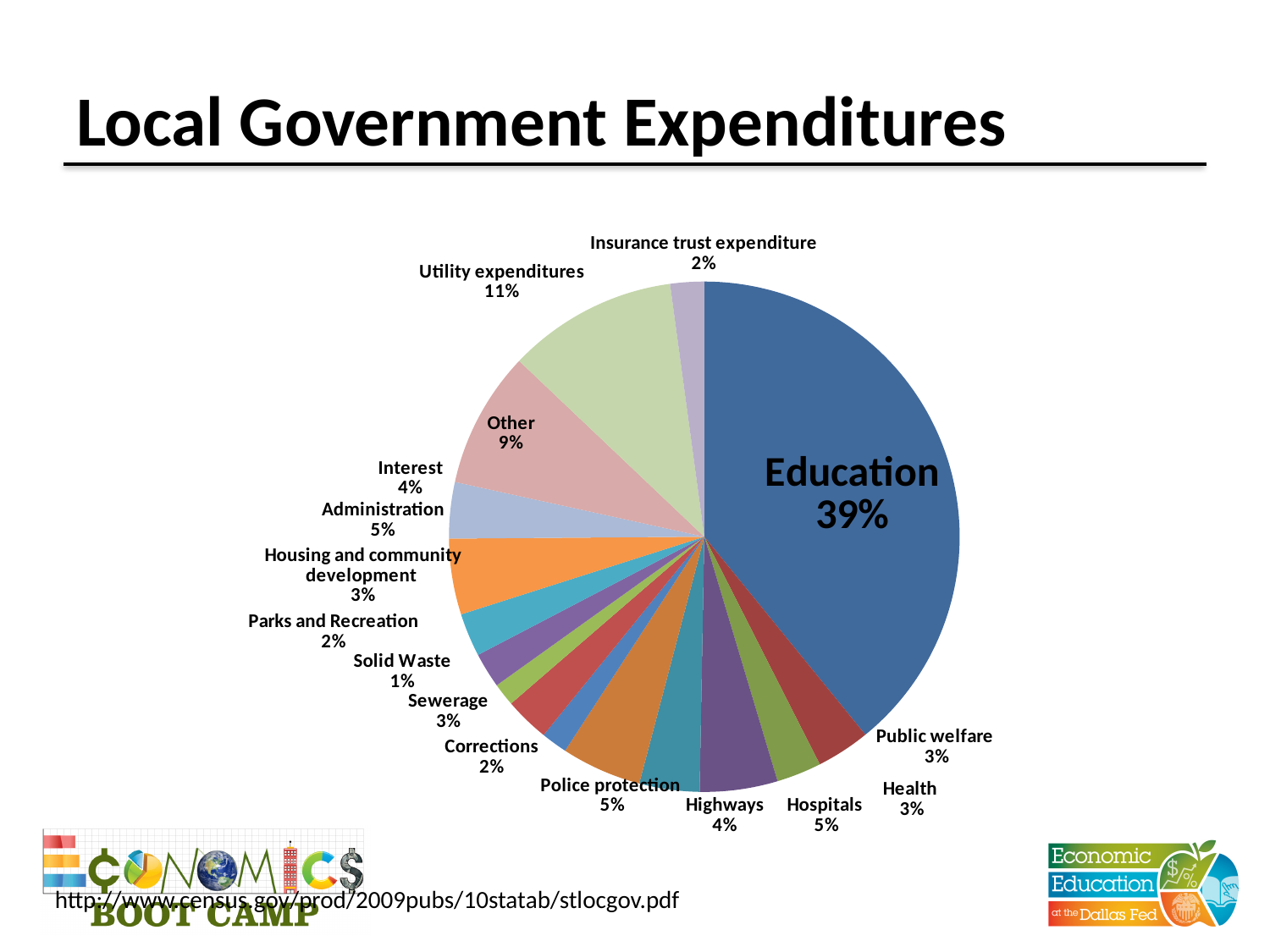
Which category has the smallest share of local government expenditures? Solid Waste What percentage is shown for Police protection? 5% What percentage is shown for Solid Waste? 1% Which category has the largest share of local government expenditures? Education What type of chart is shown on the slide? Pie chart Which has a larger share, Other or Hospitals? Other How many categories are shown in the pie chart? 16 What is the title of the slide containing the pie chart? Local Government Expenditures What is the difference in percentage points between Education and Utility expenditures? 28 What share of local government expenditures goes to Education? 39% What share of local government expenditures goes to Utility expenditures? 11% Which has a larger share, Highways or Corrections? Highways